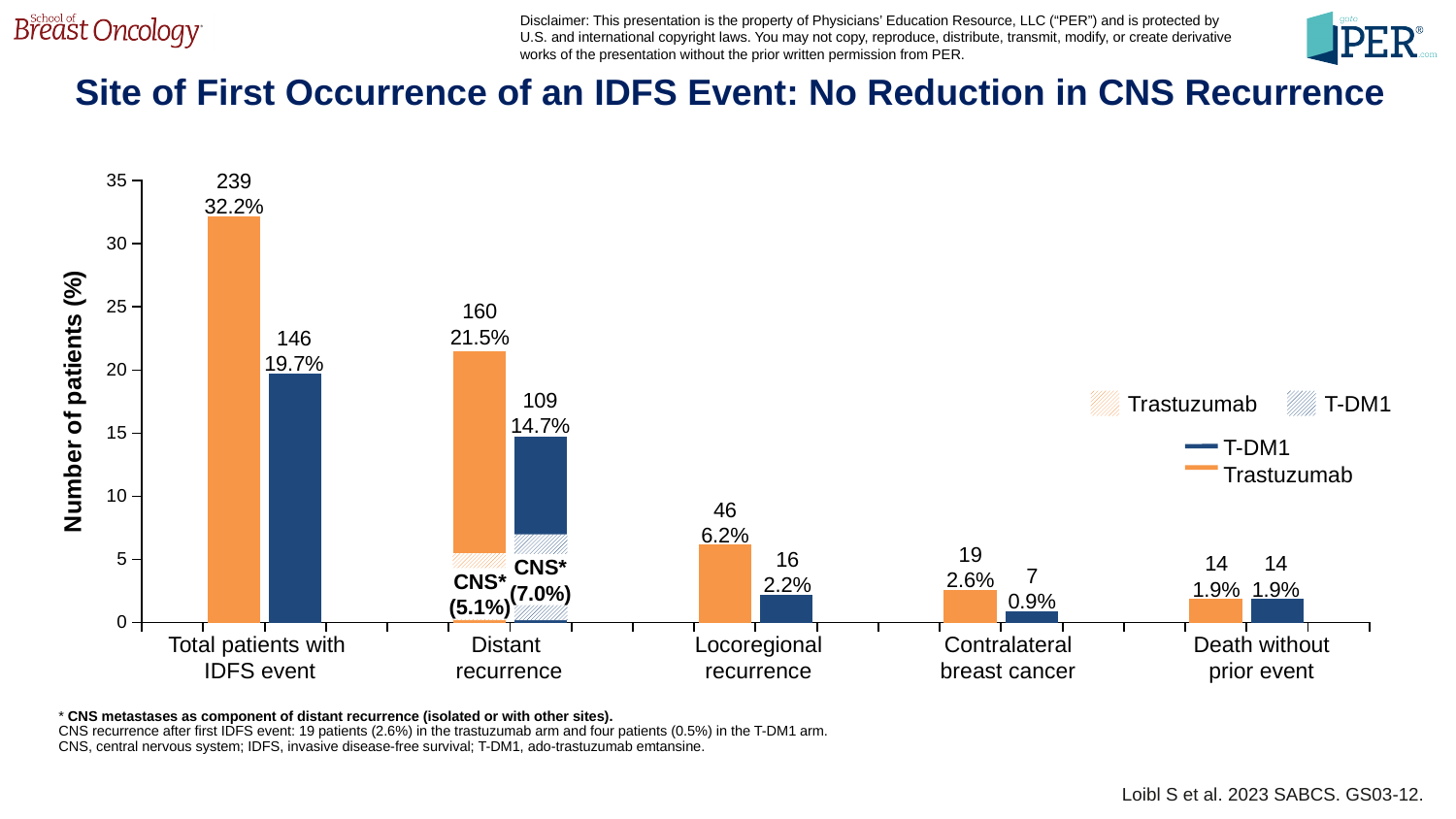
What is the difference in the number of patients with an IDFS event between the trastuzumab arm (239) and the T-DM1 arm (146)? 93 How many patients in the T-DM1 arm had a distant recurrence as the site of first IDFS event? 109 Is the percentage of trastuzumab patients with distant recurrence greater or less than 20? greater Which arm has the larger percentage of patients with distant recurrence, trastuzumab or T-DM1? Trastuzumab What is the CNS percentage shown for the T-DM1 arm within distant recurrence? 7.0% What percentage of patients in the trastuzumab arm had an IDFS event (Total patients with IDFS event)? 32.2% What percentage of T-DM1 patients had a locoregional recurrence? 2.2% What type of chart is used on this slide? Bar chart How many site categories are shown on the x axis of the chart? 5 Which site of first IDFS event has the highest percentage in the trastuzumab arm (excluding the total)? Distant recurrence What percentage of trastuzumab patients had contralateral breast cancer as the first IDFS event? 2.6% Which category has the lowest percentage for the T-DM1 arm? Contralateral breast cancer